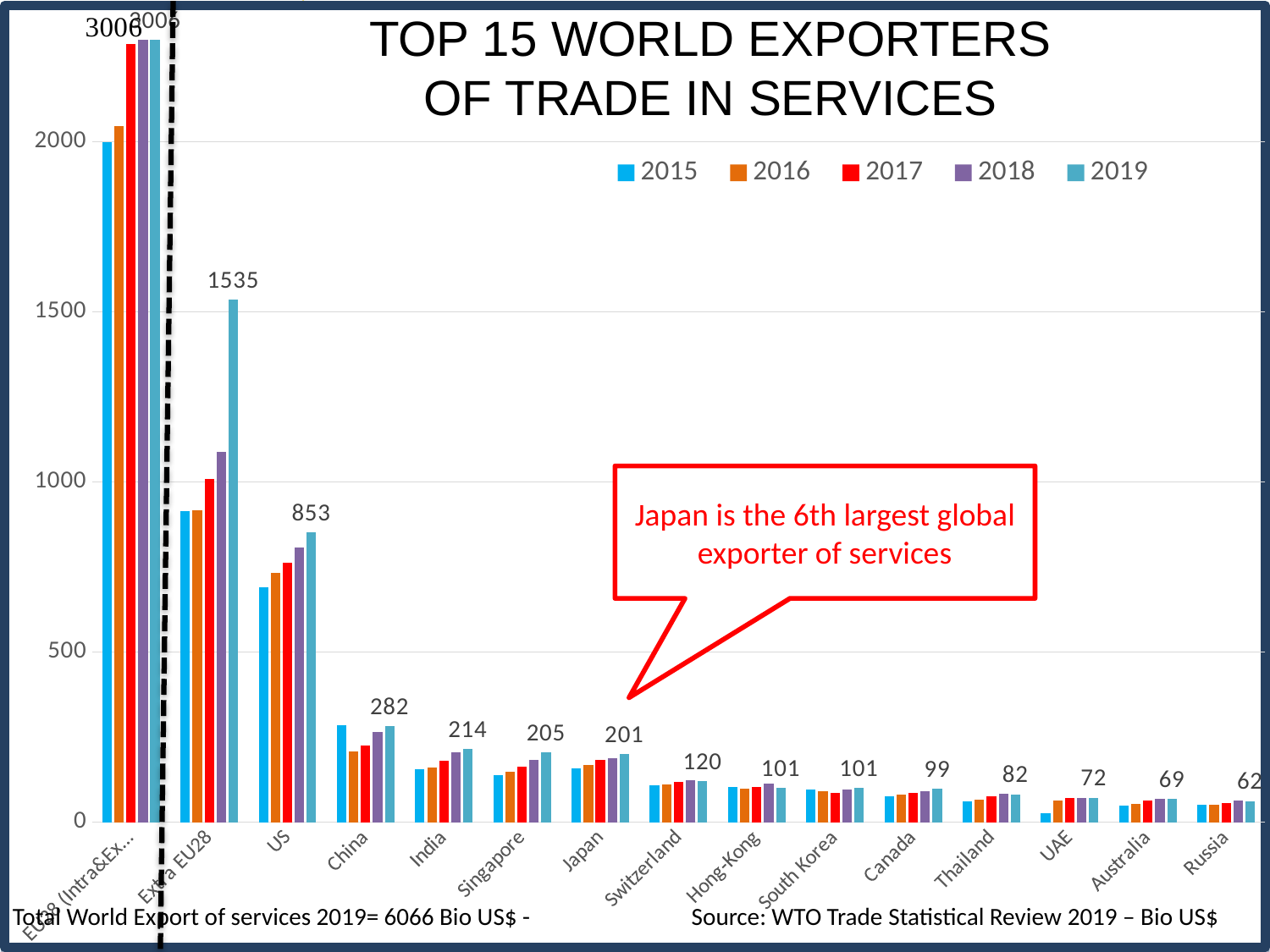
What is the 2019 value for Thailand? 82 Which has the larger 2019 value, Singapore or Japan? Singapore How many series does the legend list? 5 What is the difference between the 2019 values for Switzerland and Hong-Kong? 19 How many exporter categories are shown on the x axis? 15 What is the difference between the 2019 values for China and India? 68 Is the 2015 value for Extra EU28 greater or less than 1000? less What is the 2019 value for Japan? 201 What kind of chart is shown on the slide? Bar chart What is the 2019 value for Extra EU28? 1535 What is the 2019 value for the US? 853 Which country has the lowest 2019 value on the chart? Russia